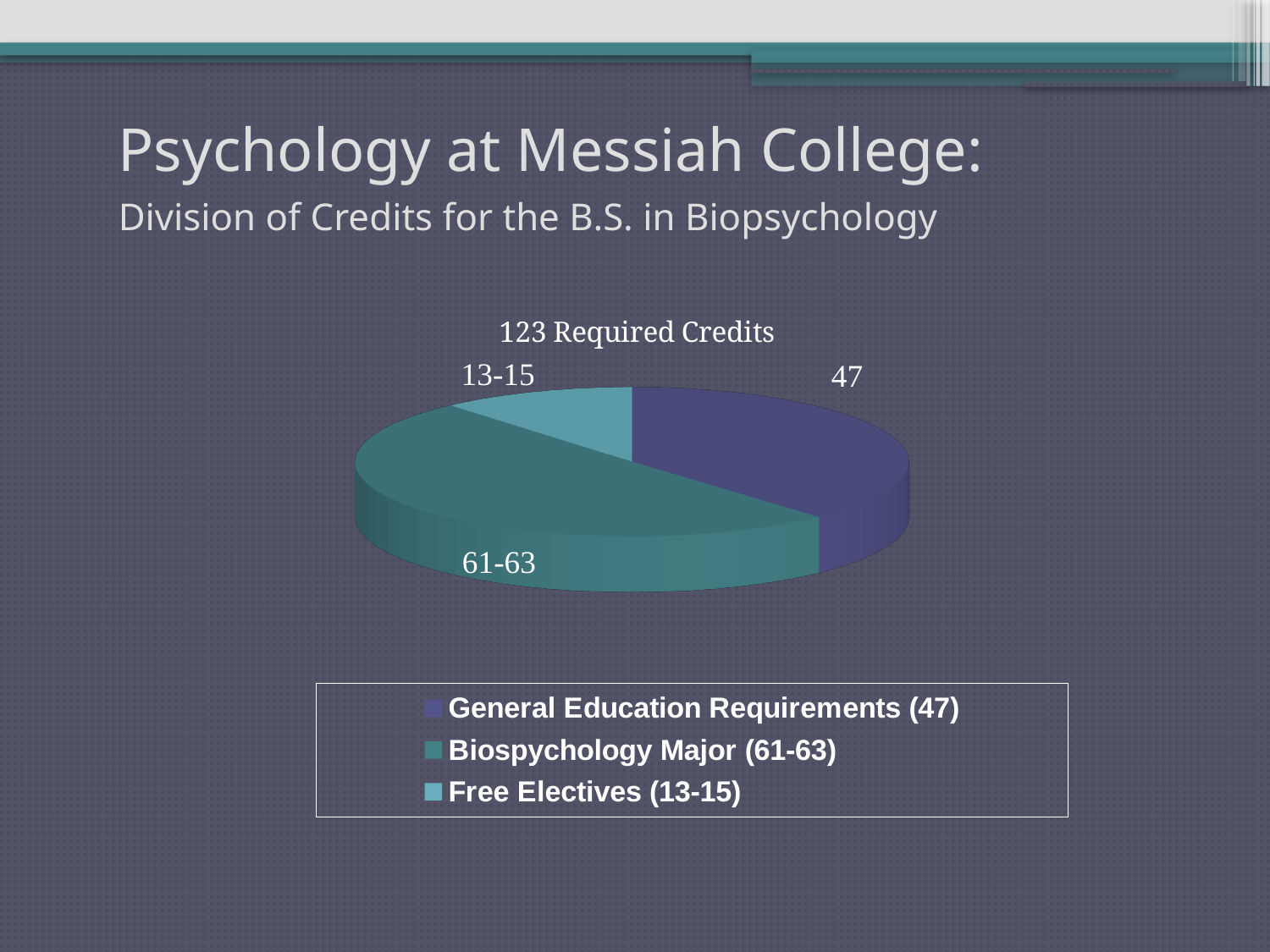
Which legend entry is shown in the lightest teal colour? Free Electives (13-15) What value is shown for General Education Requirements? 47 Which is larger, the Biopsychology Major slice or the General Education Requirements slice? Biopsychology Major What is the title of the chart? 123 Required Credits Which is larger, the General Education Requirements slice or the Free Electives slice? General Education Requirements What value is shown for Free Electives? 13-15 How many slices does the pie chart have? 3 What kind of chart is shown on the slide? pie chart How many entries does the legend list? 3 Which category has the smallest slice of the pie? Free Electives (13-15) Which category has the largest slice of the pie? Biopsychology Major (61-63) What value is shown for the Biopsychology Major slice? 61-63